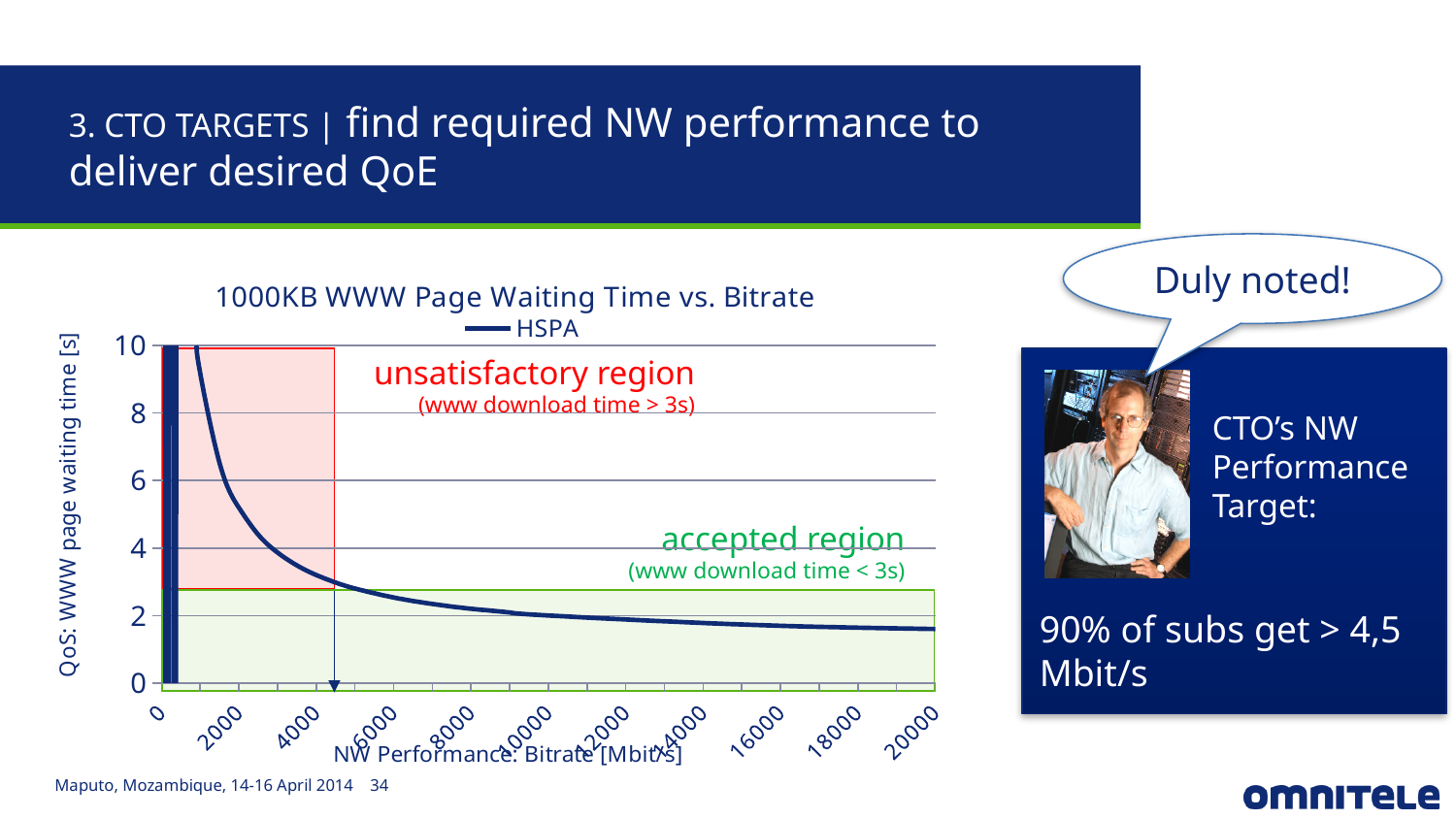
Does the HSPA waiting time rise or fall as bitrate increases along the x axis? fall Is the HSPA waiting time at a bitrate of 1000 Mbit/s greater or less than 4 s? greater Which region of the chart corresponds to a www download time greater than 3s? unsatisfactory region What is the name of the series shown in the legend? HSPA Is the HSPA waiting time at a bitrate of 16000 Mbit/s greater or less than 4 s? less What is the highest value shown on the y axis? 10 How many tick labels are shown on the x axis? 11 What type of chart is shown on the slide? line chart Is the HSPA waiting time at a bitrate of 20000 Mbit/s greater or less than 2 s? less How many series does the chart legend list? 1